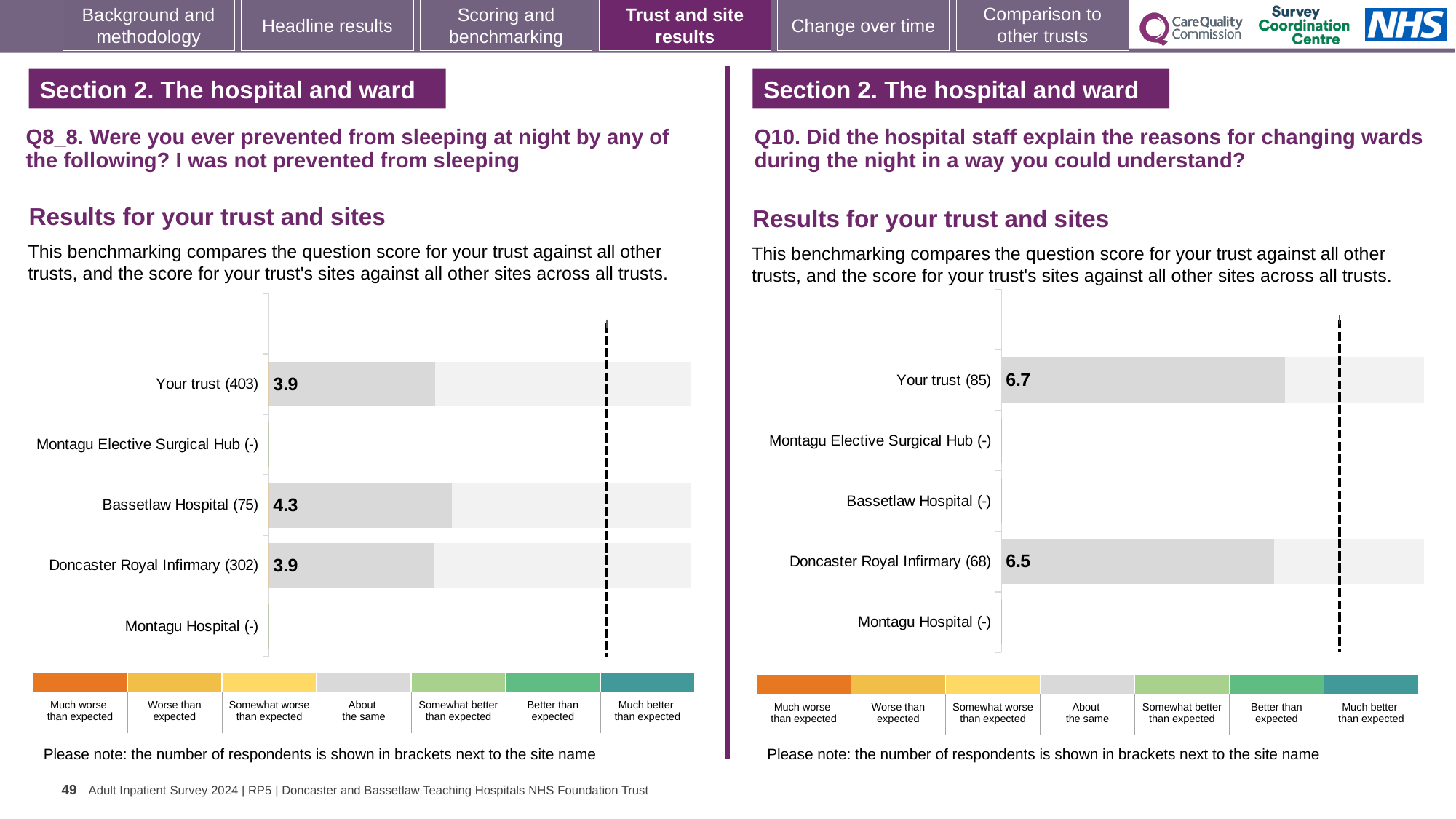
On the right chart (Q10), what is the difference between the scores for Your trust and Doncaster Royal Infirmary? 0.2 On the right chart (Q10), what is the score for Your trust? 6.7 On the left chart (Q8_8), what is the difference between the scores for Bassetlaw Hospital and Doncaster Royal Infirmary? 0.4 On the left chart (Q8_8), how many respondents are shown in brackets for Doncaster Royal Infirmary? 302 What type of chart is used on the left side of the slide (Q8_8)? Bar chart On the right chart (Q10), how many respondents are shown in brackets for Your trust? 85 On the right chart (Q10), which is larger, the score for Your trust or for Doncaster Royal Infirmary? Your trust On the left chart (Q8_8), what is the score for Your trust? 3.9 On the right chart (Q10), what is the score for Doncaster Royal Infirmary? 6.5 On the left chart (Q8_8), which site has the highest score? Bassetlaw Hospital On the left chart (Q8_8), what is the score for Bassetlaw Hospital? 4.3 On the right chart (Q10), how many site rows are listed on the vertical axis? 5